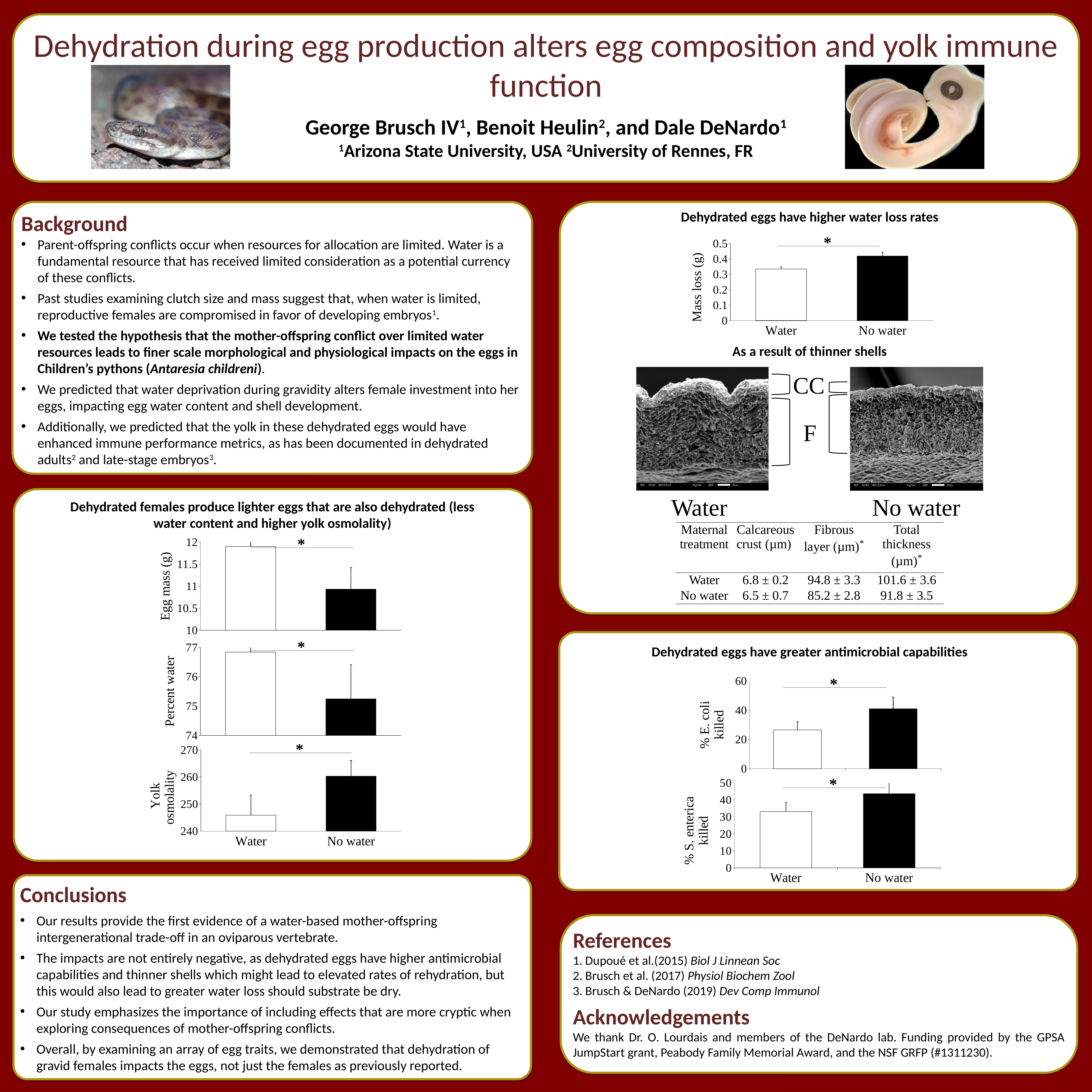
In the Egg mass (g) chart, is the value for No water greater or less than 11.5? less In the Egg mass (g) chart, which treatment has the lower egg mass? No water In the 'Dehydrated eggs have higher water loss rates' chart, which treatment has the higher mass loss? No water In the Yolk osmolality chart, is the value for Water greater or less than 250? less In the '% S. enterica killed' chart, which treatment has the higher percentage killed, Water or No water? No water In the Percent water chart, is the value for Water greater or less than 76? greater In the Yolk osmolality chart, which treatment has the higher yolk osmolality? No water How many treatment categories are shown on the x axis of the '% S. enterica killed' chart? 2 What kind of chart is used in the 'Dehydrated eggs have higher water loss rates' panel? bar chart